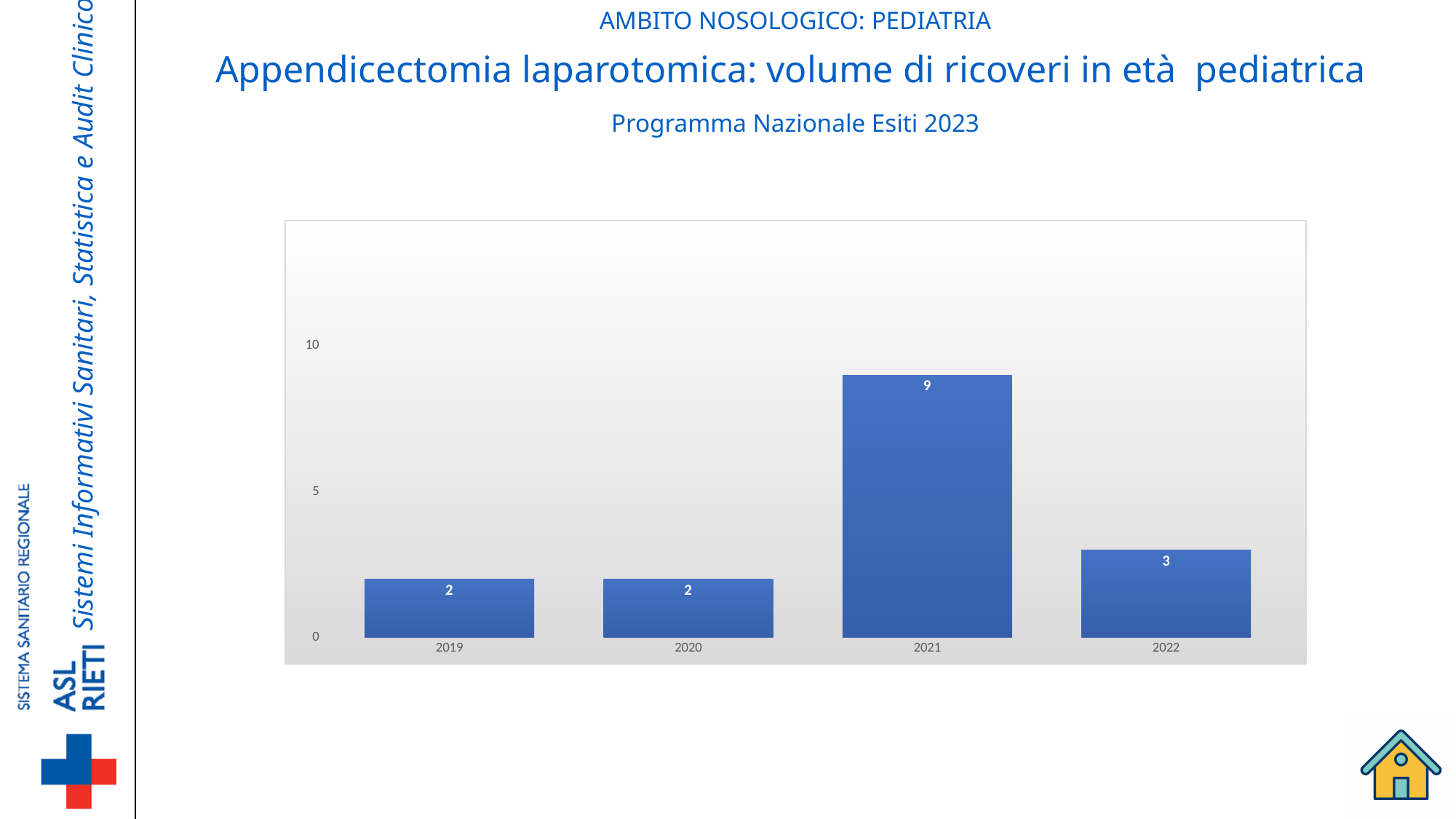
What is the difference between the values for 2022 and 2020? 1 What kind of chart is shown on the slide? bar chart What is the value for 2022? 3 Which year has the highest value? 2021 Is the value for 2021 greater or less than 5? greater What is the value for 2021? 9 What is the total of the values for 2019 and 2020? 4 Which is larger, the value for 2021 or the value for 2022? 2021 What is the difference between the values for 2021 and 2022? 6 How many years are shown on the x axis? 4 Is the value for 2019 greater or less than 5? less What is the value for 2019? 2